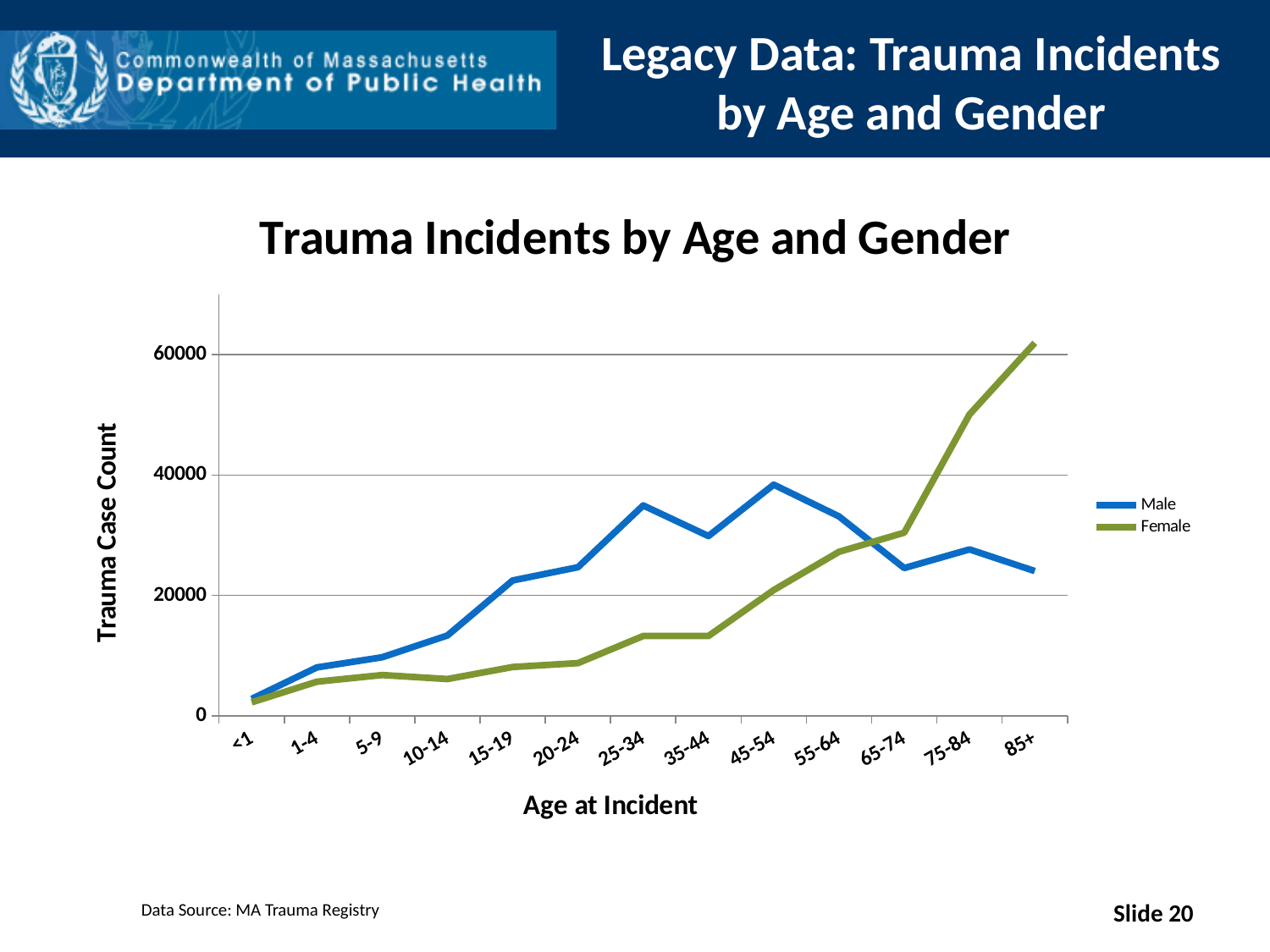
Which age group has the highest Male trauma case count? 45-54 Which series has the larger value for the 25-34 age group, Male or Female? Male How many series does the legend list? 2 Is the Male value for 45-54 greater or less than 40000? less What kind of chart is shown on the slide? line chart Which age group has the highest Female trauma case count? 85+ How many age groups are shown on the x axis? 13 Is the Female value for 85+ greater or less than 60000? greater Does the Female line generally rise or fall from <1 to 85+? rise What is the label of the y axis? Trauma Case Count Is the Female value for 35-44 greater or less than 20000? less Which age group has the lowest Male trauma case count? <1